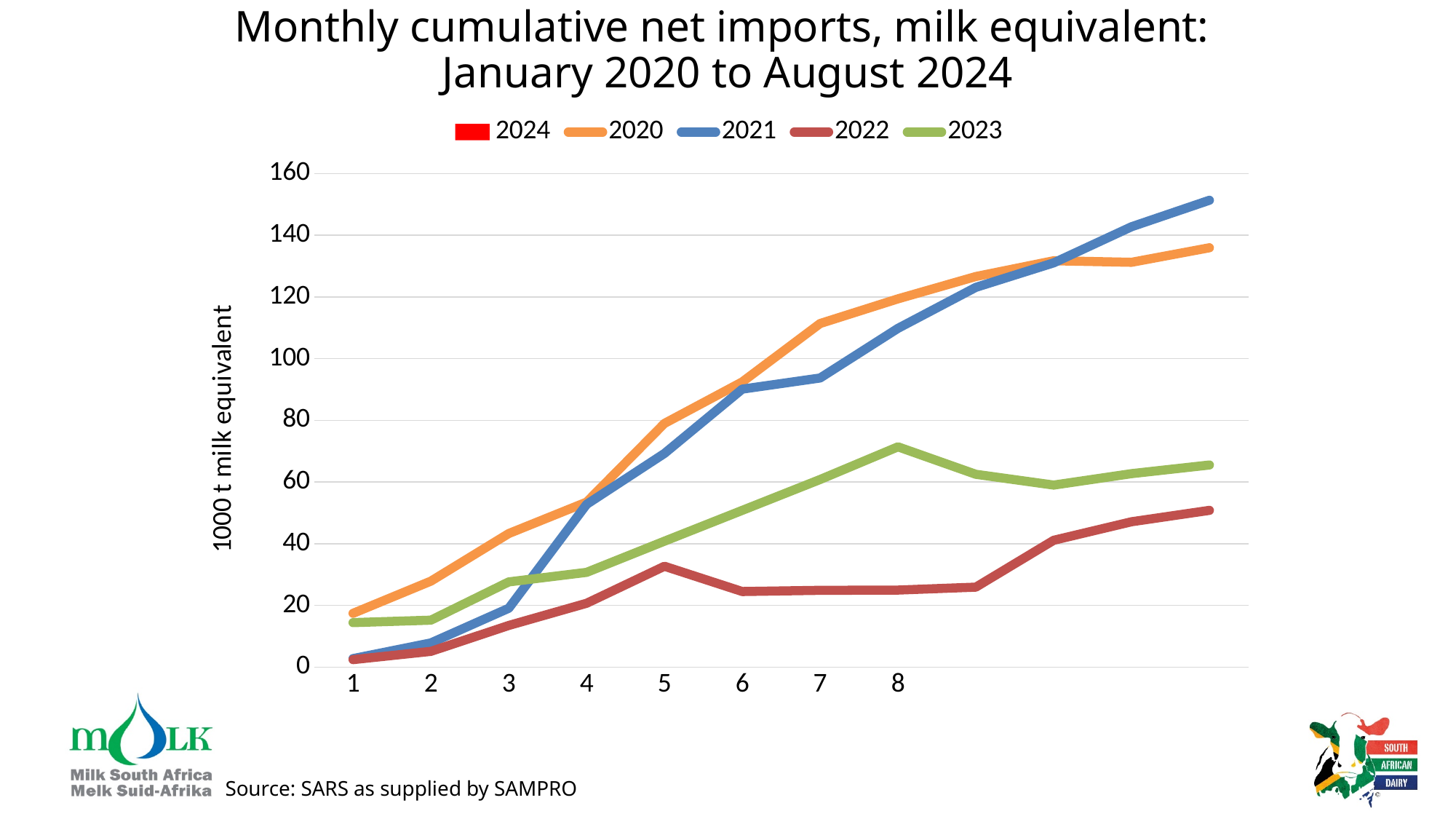
At month 3, which series has the larger value, 2023 or 2021? 2023 What kind of chart is shown on the slide? line chart Which series reaches the highest value at the right-hand end of the chart? 2021 Is the value for 2020 at month 7 greater or less than 100? greater Is the value for 2022 at month 6 greater or less than 40? less Is the value for 2021 at month 8 greater or less than 100? greater Does the 2021 series rise or fall as the months increase? rise What is the label on the vertical axis? 1000 t milk equivalent At month 8, which series has the larger value, 2020 or 2021? 2020 Which series has the lowest value at month 8? 2022 How many series does the legend list? 5